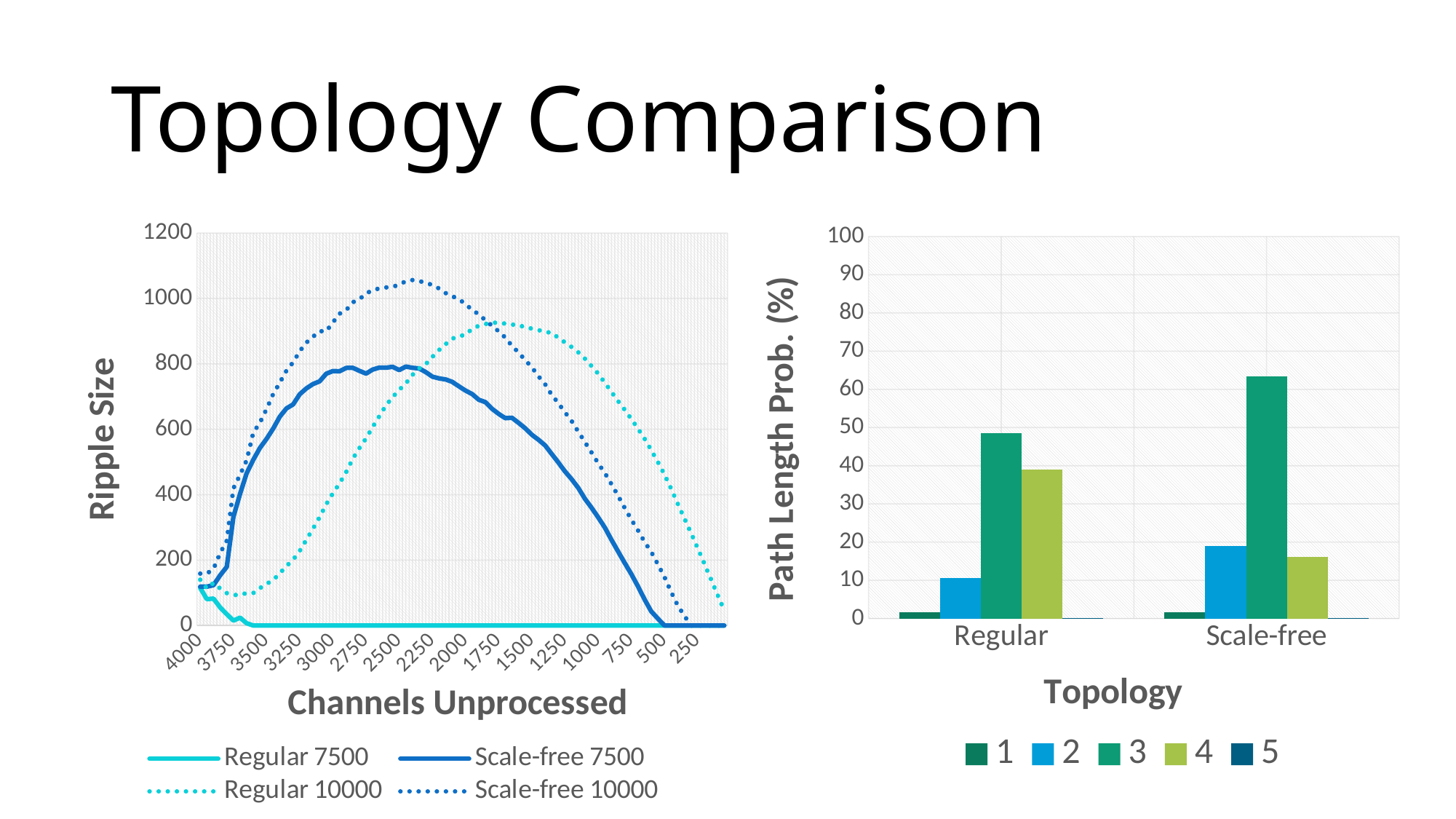
On the right chart (Path Length Prob. vs Topology), what kind of chart is it? bar chart On the right chart (Path Length Prob. vs Topology), is the value for series 2 larger for Regular or for Scale-free? Scale-free On the left chart (Ripple Size vs Channels Unprocessed), how many series does the legend list? 4 On the left chart (Ripple Size vs Channels Unprocessed), what kind of chart is it? line chart On the right chart (Path Length Prob. vs Topology), is the value for series 3 under Scale-free greater or less than 60? greater On the left chart (Ripple Size vs Channels Unprocessed), which series reaches the highest peak ripple size? Scale-free 10000 On the right chart (Path Length Prob. vs Topology), which series has the highest value for Scale-free? 3 On the right chart (Path Length Prob. vs Topology), how many topology categories are shown on the x axis? 2 On the right chart (Path Length Prob. vs Topology), how many series does the legend list? 5 On the left chart (Ripple Size vs Channels Unprocessed), is the peak value of the Scale-free 10000 series greater or less than 1000? greater On the right chart (Path Length Prob. vs Topology), is the value for series 4 under Regular larger for Regular or for Scale-free? Regular On the right chart (Path Length Prob. vs Topology), is the value for series 3 under Regular greater or less than 40? greater